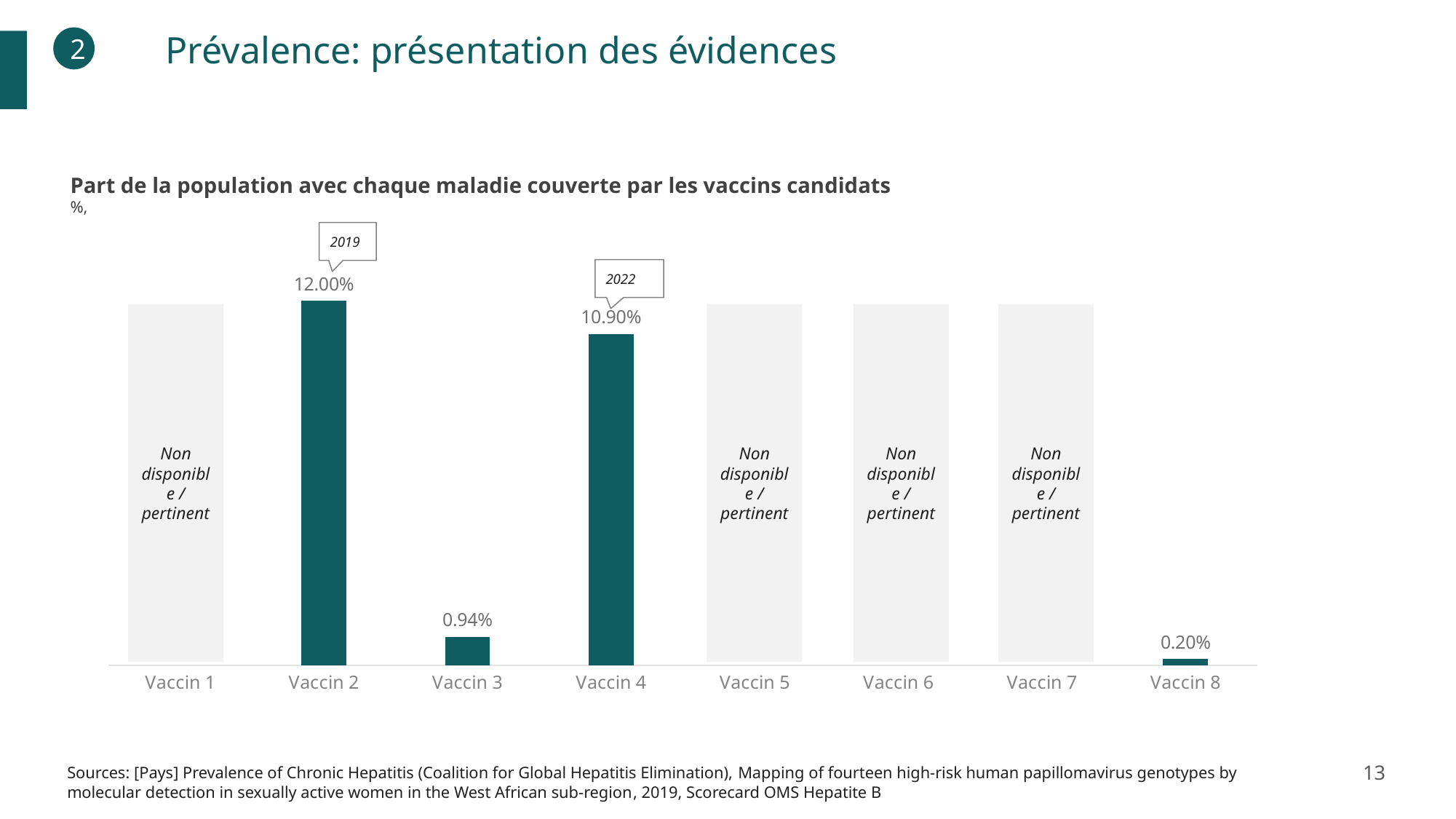
What is the value for Vaccin 8? 0.20% What label is shown for Vaccin 1, Vaccin 5, Vaccin 6 and Vaccin 7 instead of a value? Non disponible / pertinent How many vaccine categories are shown on the x axis? 8 What is the value for Vaccin 2? 12.00% What is the value for Vaccin 4? 10.90% Which vaccine has the highest plotted value? Vaccin 2 What kind of chart is shown on the slide? Bar chart What is the difference between the values for Vaccin 3 and Vaccin 8? 0.74% Which is larger, the value for Vaccin 3 or the value for Vaccin 4? Vaccin 4 What is the value for Vaccin 3? 0.94% What is the difference between the values for Vaccin 2 and Vaccin 4? 1.10% Which vaccine has the lowest plotted value? Vaccin 8